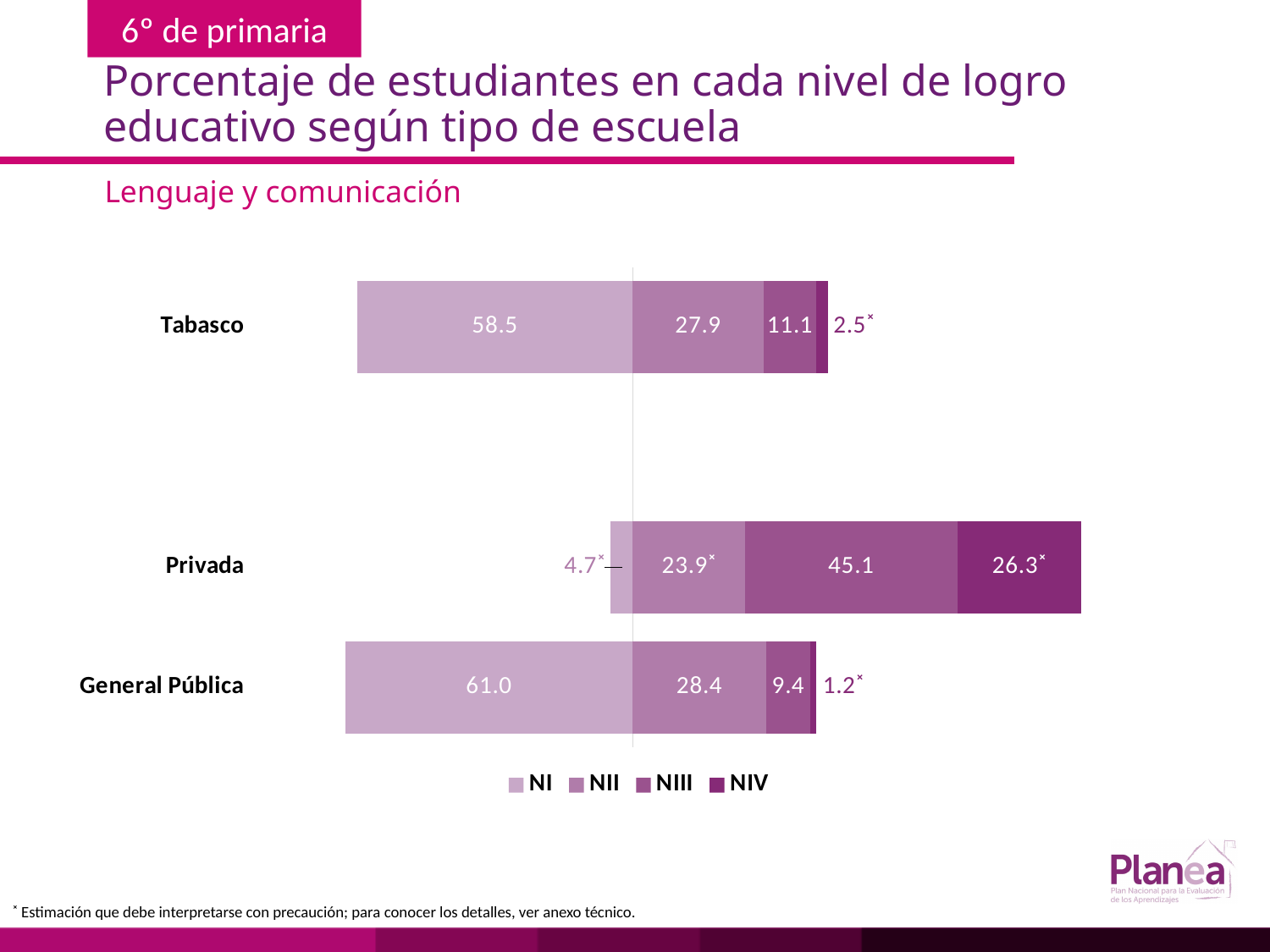
What is the NIII value for Privada? 45.1 Which school type has the highest NI value? General Pública How many school types (categories) are shown in the chart? 3 What is the difference between the NI values for General Pública and Tabasco? 2.5 What is the total of the stacked bar for Privada? 100.0 Which school type has the lowest NI value? Privada What is the NII value for General Pública? 28.4 What is the NIII value for General Pública? 9.4 How many series does the legend list? 4 What kind of chart is shown on the slide? Stacked bar chart Which is larger, the NII value for Tabasco or the NII value for General Pública? General Pública What is the NI value for Tabasco? 58.5